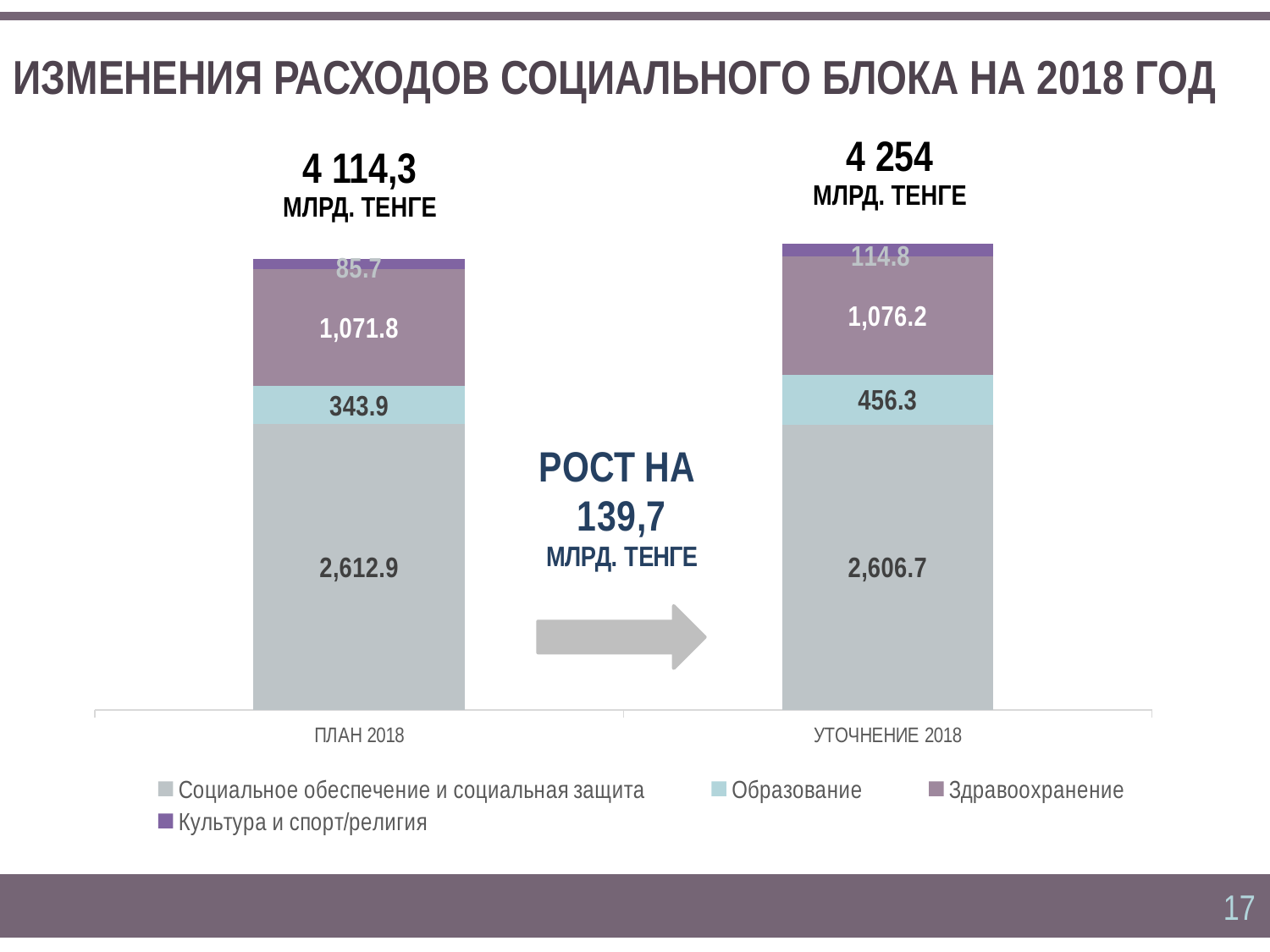
How many categories are shown on the x axis? 2 Which series has the smallest value in the УТОЧНЕНИЕ 2018 bar? Культура и спорт/религия How many series does the legend list? 4 Which series has the largest value in the ПЛАН 2018 bar? Социальное обеспечение и социальная защита What is the total of the УТОЧНЕНИЕ 2018 stacked bar, as printed on the slide? 4 254 млрд. тенге What type of chart is shown on the slide? Stacked bar chart What is the value for Социальное обеспечение и социальная защита in the УТОЧНЕНИЕ 2018 bar? 2,606.7 What is the value for Культура и спорт/религия in the ПЛАН 2018 bar? 85.7 What is the difference between the Образование values for УТОЧНЕНИЕ 2018 and ПЛАН 2018? 112.4 Which is larger: Здравоохранение in ПЛАН 2018 or Здравоохранение in УТОЧНЕНИЕ 2018? УТОЧНЕНИЕ 2018 What is the value for Образование in the ПЛАН 2018 bar? 343.9 What is the value for Здравоохранение in the УТОЧНЕНИЕ 2018 bar? 1,076.2